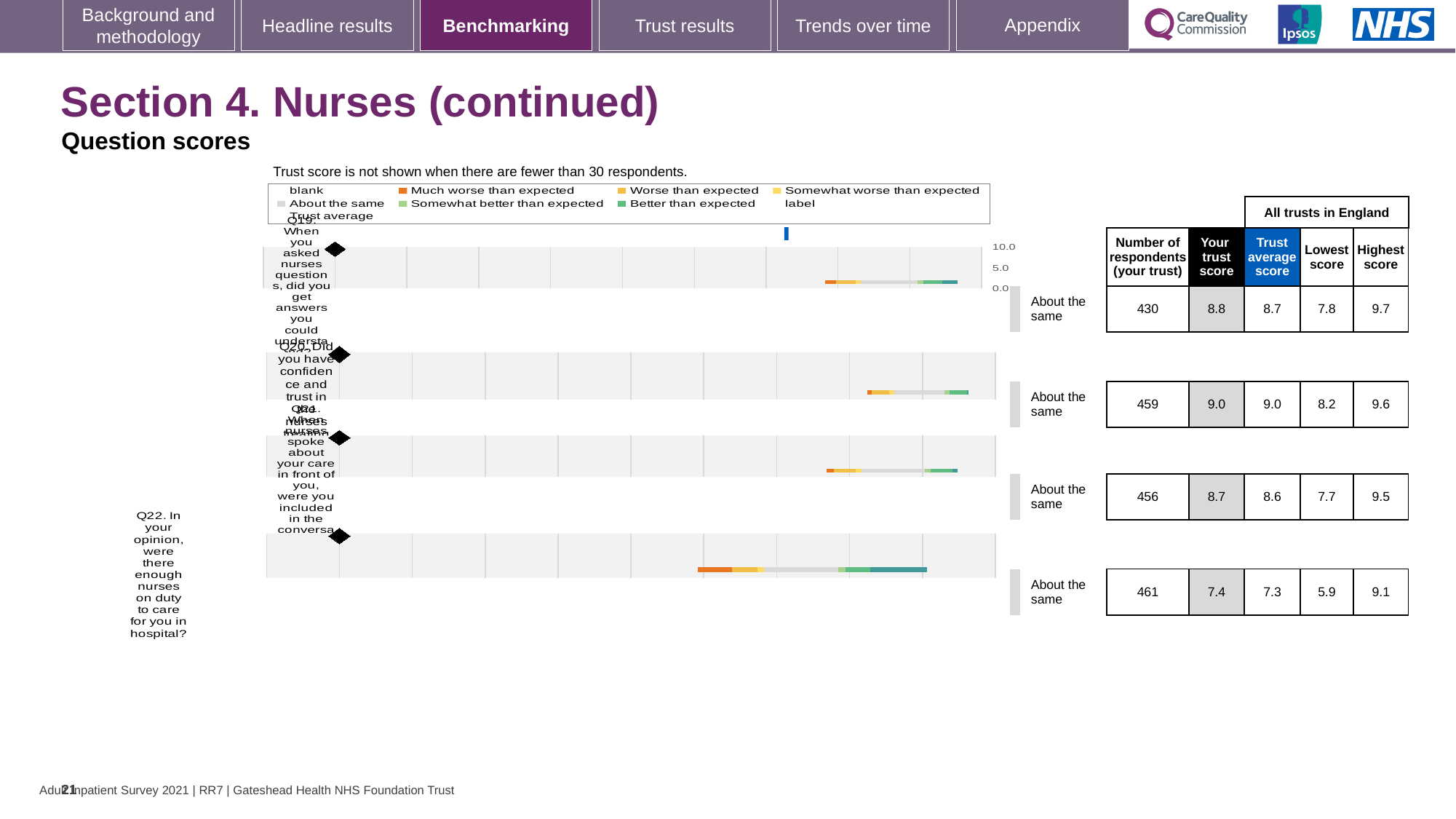
What is the difference between the highest score and the lowest score for Q22? 3.2 What is the trust score for Q22 (enough nurses on duty)? 7.4 Is the trust score for Q19 or Q22 higher? Q19 How many questions (Q19 to Q22) are plotted in the chart? 4 What is the trust average score for Q19? 8.7 What kind of chart is used to show the question scores on this slide? Bar chart What benchmark category is shown for Q21? About the same How many respondents answered Q20 (confidence and trust in nurses) at this trust? 459 Which question has the highest trust score for this trust? Q20 Which legend entry is shown in orange? Much worse than expected Which question has the lowest trust score for this trust? Q22 What is the highest value shown on the chart's score axis? 10.0